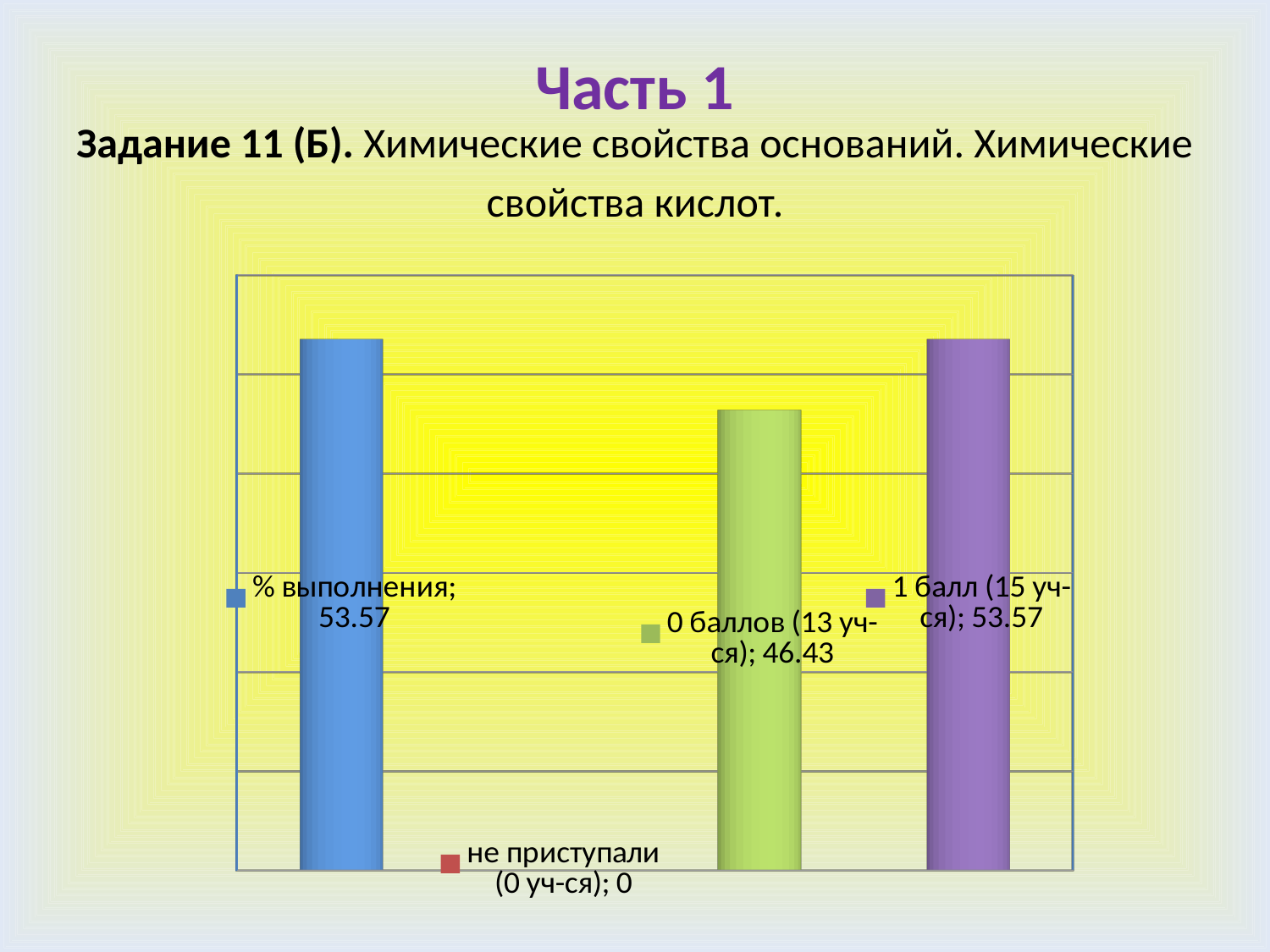
Which category has the lowest value? не приступали (0 уч-ся) What is the value for "1 балл (15 уч-ся)"? 53.57 What kind of chart is shown on the slide? bar chart What colour is the bar for "1 балл (15 уч-ся)"? purple What is the value for "не приступали (0 уч-ся)"? 0 Do the values for "% выполнения" and "1 балл (15 уч-ся)" match? yes Which is larger, the value for "0 баллов (13 уч-ся)" or the value for "1 балл (15 уч-ся)"? 1 балл (15 уч-ся) How many categories are shown in the chart? 4 What is the difference between the values for "1 балл (15 уч-ся)" and "0 баллов (13 уч-ся)"? 7.14 What is the value for "0 баллов (13 уч-ся)"? 46.43 How many students scored 0 points according to the category label? 13 What is the value for "% выполнения"? 53.57